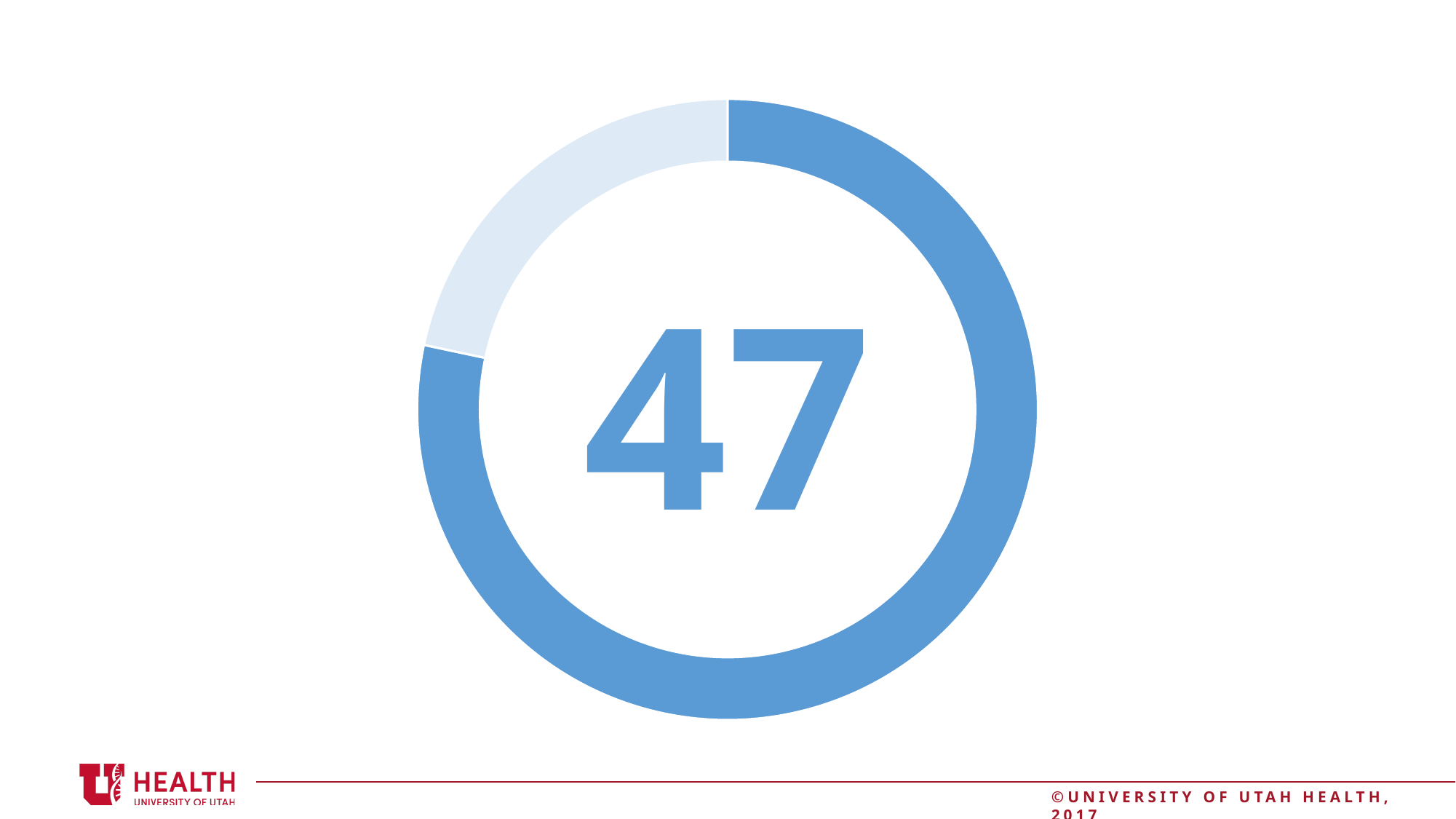
What number is printed in the center of the doughnut chart? 47 What kind of chart is shown on the slide? doughnut chart Which segment of the doughnut chart is the smallest? the light blue one Does the light blue segment cover more or less than half of the doughnut chart? less Does the doughnut chart have a legend? No Does the dark blue segment cover more or less than half of the doughnut chart? more How many segments does the doughnut chart have? 2 Which segment of the doughnut chart is larger, the dark blue one or the light blue one? the dark blue one